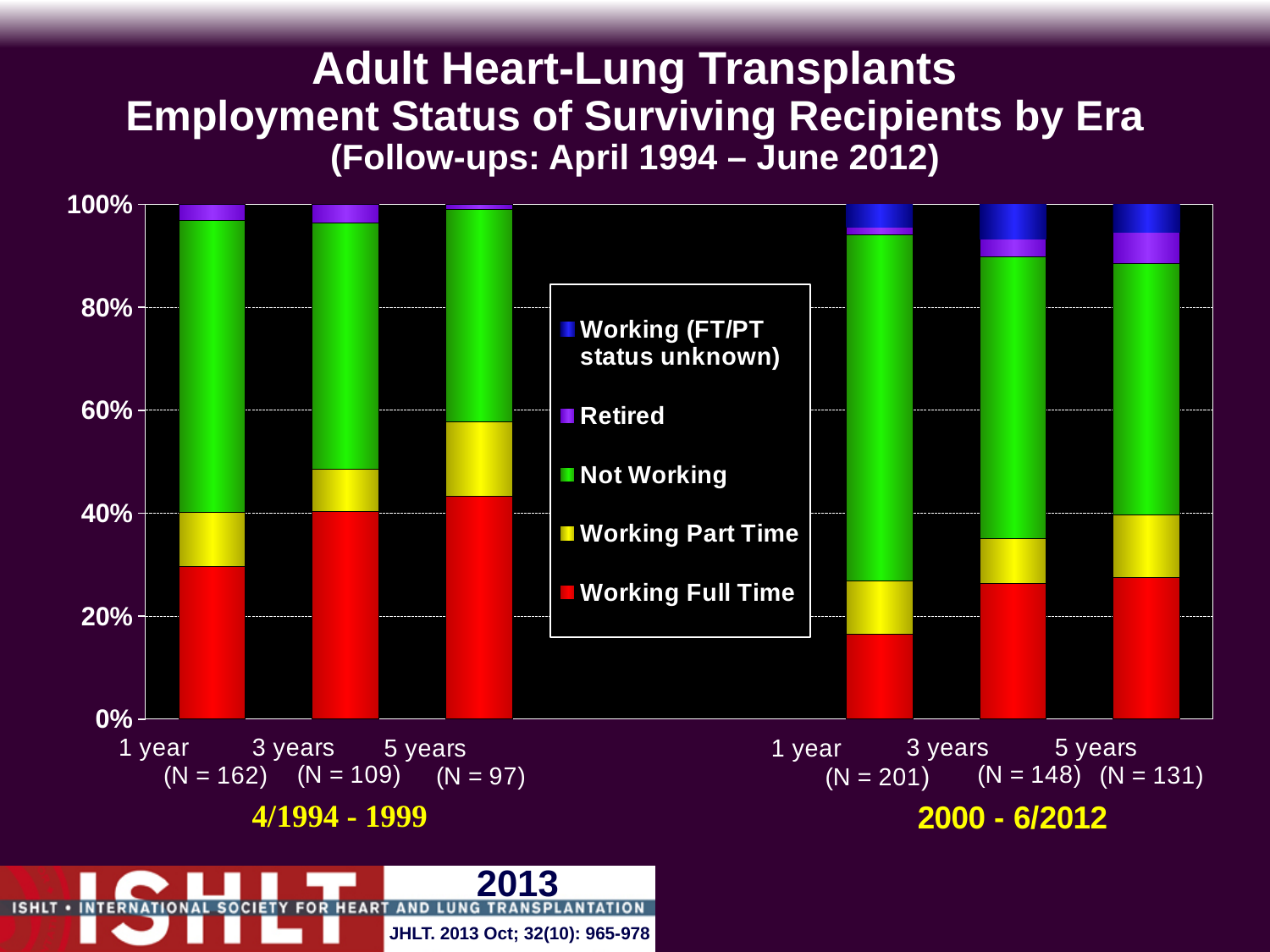
Within the 2000 - 6/2012 era, does the Working Full Time share rise or fall from 1 year to 5 years? rises What kind of chart is shown on the slide? Stacked bar chart What is the sample size (N) for the 1 year group in the 4/1994 - 1999 era? 162 Is the Working Full Time value for 1 year in the 2000 - 6/2012 era greater or less than 20%? less Which era has the larger Working Full Time share at 5 years: 4/1994 - 1999 or 2000 - 6/2012? 4/1994 - 1999 Is the Working Full Time value for 3 years in the 2000 - 6/2012 era greater or less than 20%? greater Is the Working Full Time value for 5 years in the 2000 - 6/2012 era greater or less than 40%? less How many bars are plotted in the chart in total? 6 How many series does the legend list? 5 Which era has the larger Working Full Time share at 1 year: 4/1994 - 1999 or 2000 - 6/2012? 4/1994 - 1999 What is the sample size (N) for the 5 years group in the 2000 - 6/2012 era? 131